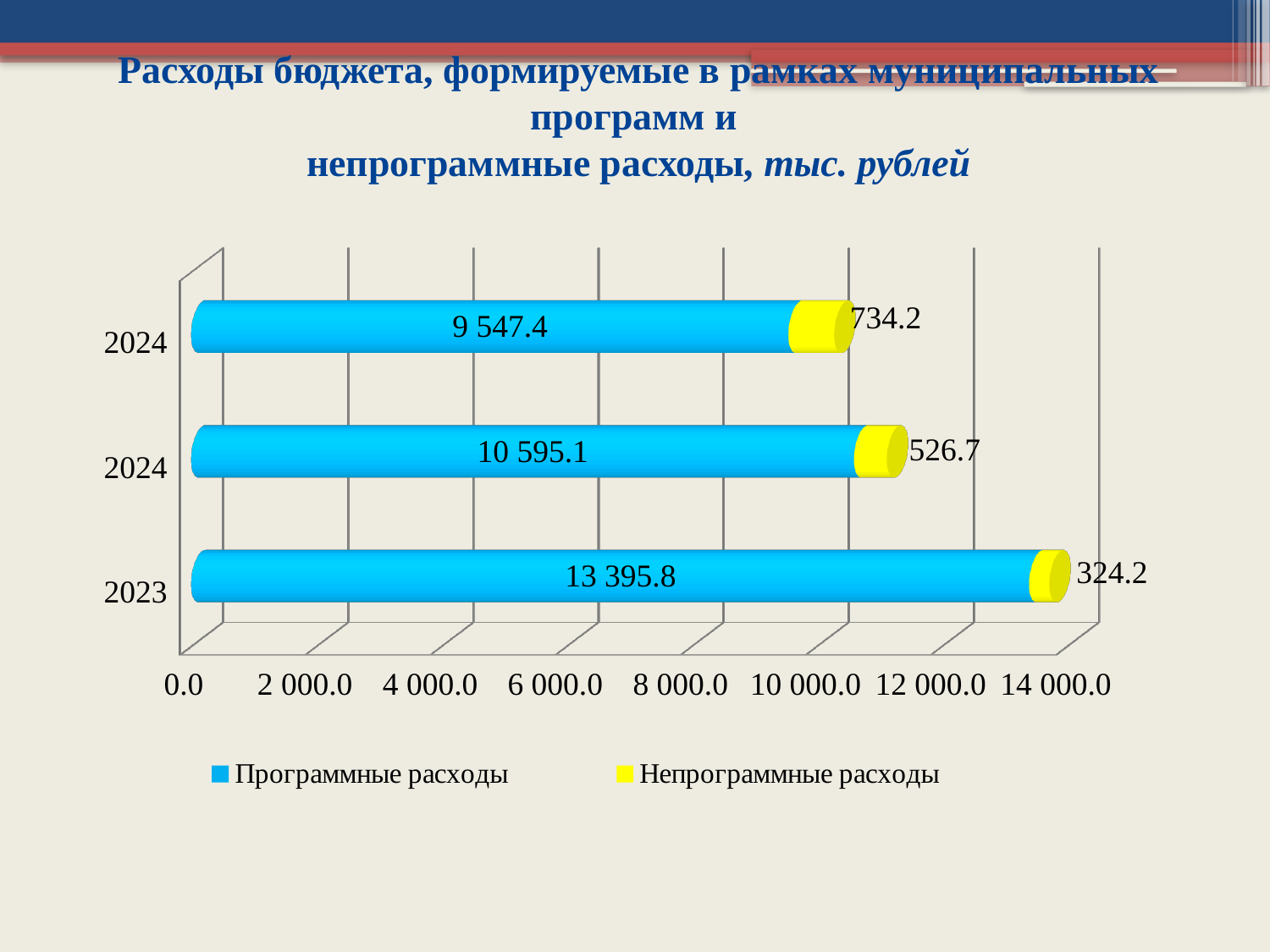
What is the value of Программные расходы for 2023? 13 395.8 What is the difference between Программные расходы for 2023 and for the middle bar (10 595.1)? 2 800.7 What kind of chart is shown on the slide? Bar chart What is the value of Программные расходы for the top bar (labelled 2024)? 9 547.4 What is the value of Непрограммные расходы for the middle bar (labelled 2024)? 526.7 How many series does the legend list? 2 What is the value of Непрограммные расходы for 2023? 324.2 What is the value of Программные расходы for the middle bar (labelled 2024)? 10 595.1 Which bar has the lowest value of Непрограммные расходы? 2023 What is the value of Непрограммные расходы for the top bar (labelled 2024)? 734.2 Which bar has the highest value of Программные расходы? 2023 What is the total of the 2023 bar (Программные plus Непрограммные расходы)? 13 720.0